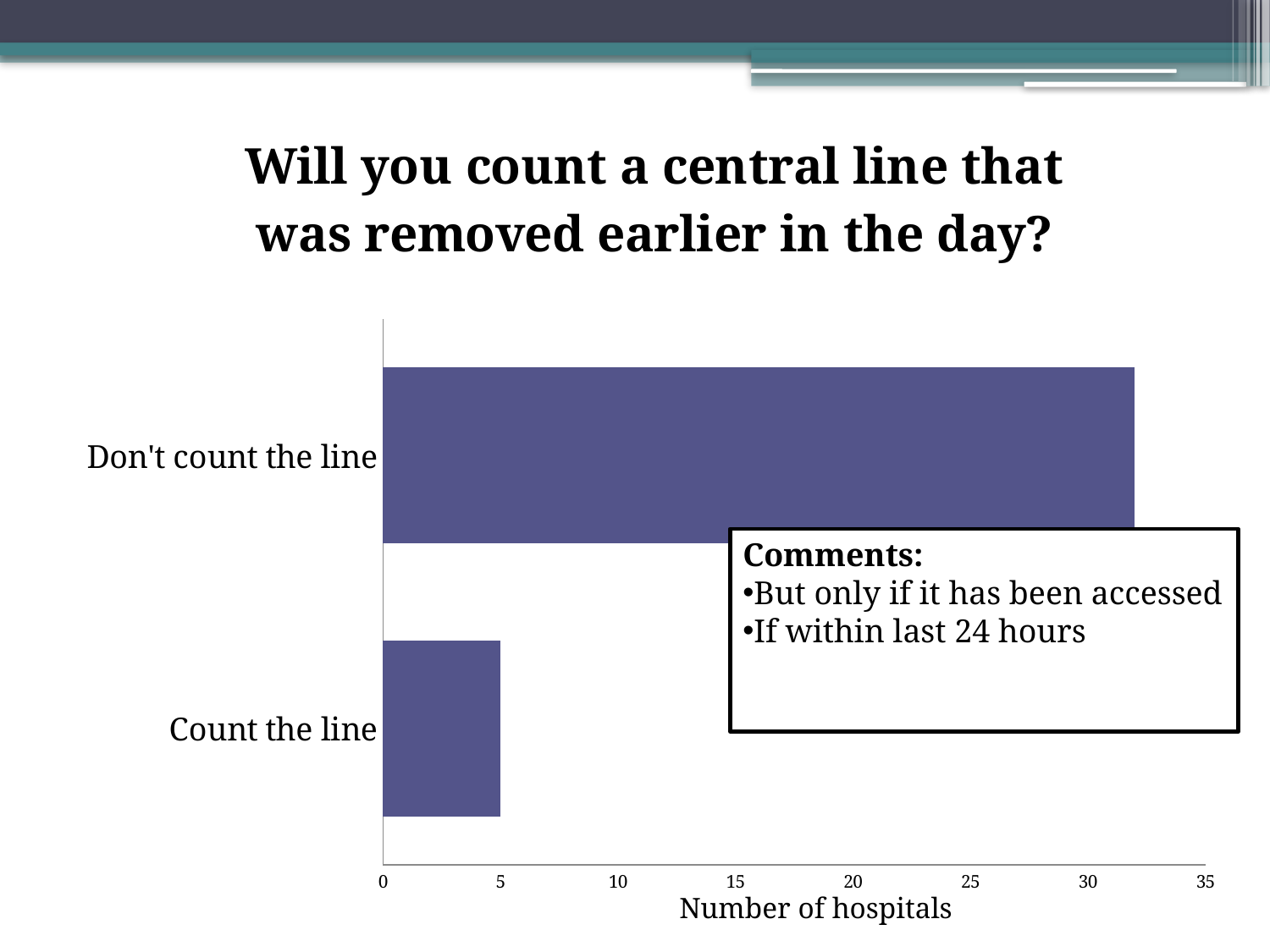
What is the label of the horizontal axis? Number of hospitals Is the value for "Don't count the line" greater or less than 30? greater What kind of chart is shown on the slide? bar chart How many hospitals answered "Count the line"? 5 Is the value for "Don't count the line" greater or less than 35? less Which category has the lowest number of hospitals? Count the line Which category has the highest number of hospitals? Don't count the line What is the title of the chart? Will you count a central line that was removed earlier in the day? Is the value for "Count the line" greater or less than 10? less How many categories are plotted in the chart? 2 Which is larger: the number of hospitals for "Don't count the line" or for "Count the line"? Don't count the line